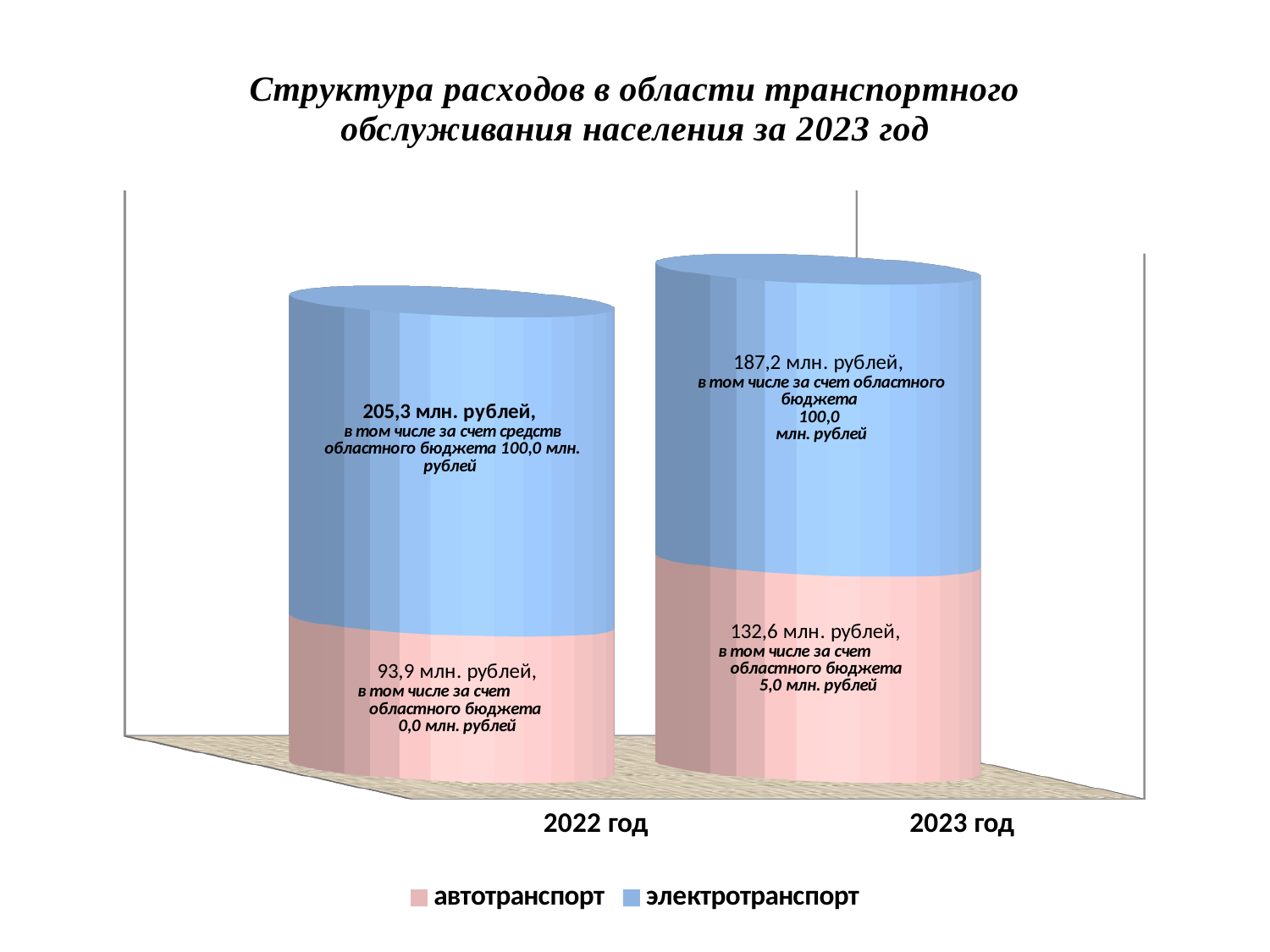
What is the difference between the автотранспорт values for 2023 год and 2022 год? 38,7 млн. рублей What is the difference between the электротранспорт values for 2022 год and 2023 год? 18,1 млн. рублей What is the value for автотранспорт in 2023 год? 132,6 млн. рублей What is the value for автотранспорт in 2022 год? 93,9 млн. рублей How many series does the legend list? 2 What is the total of the stacked bar for 2023 год? 319,8 млн. рублей Which year has the higher value for автотранспорт, 2022 год or 2023 год? 2023 год Which year has the higher value for электротранспорт, 2022 год or 2023 год? 2022 год What is the value for электротранспорт in 2023 год? 187,2 млн. рублей What kind of chart is shown on the slide? Stacked bar chart What is the value for электротранспорт in 2022 год? 205,3 млн. рублей What is the total of the stacked bar for 2022 год? 299,2 млн. рублей